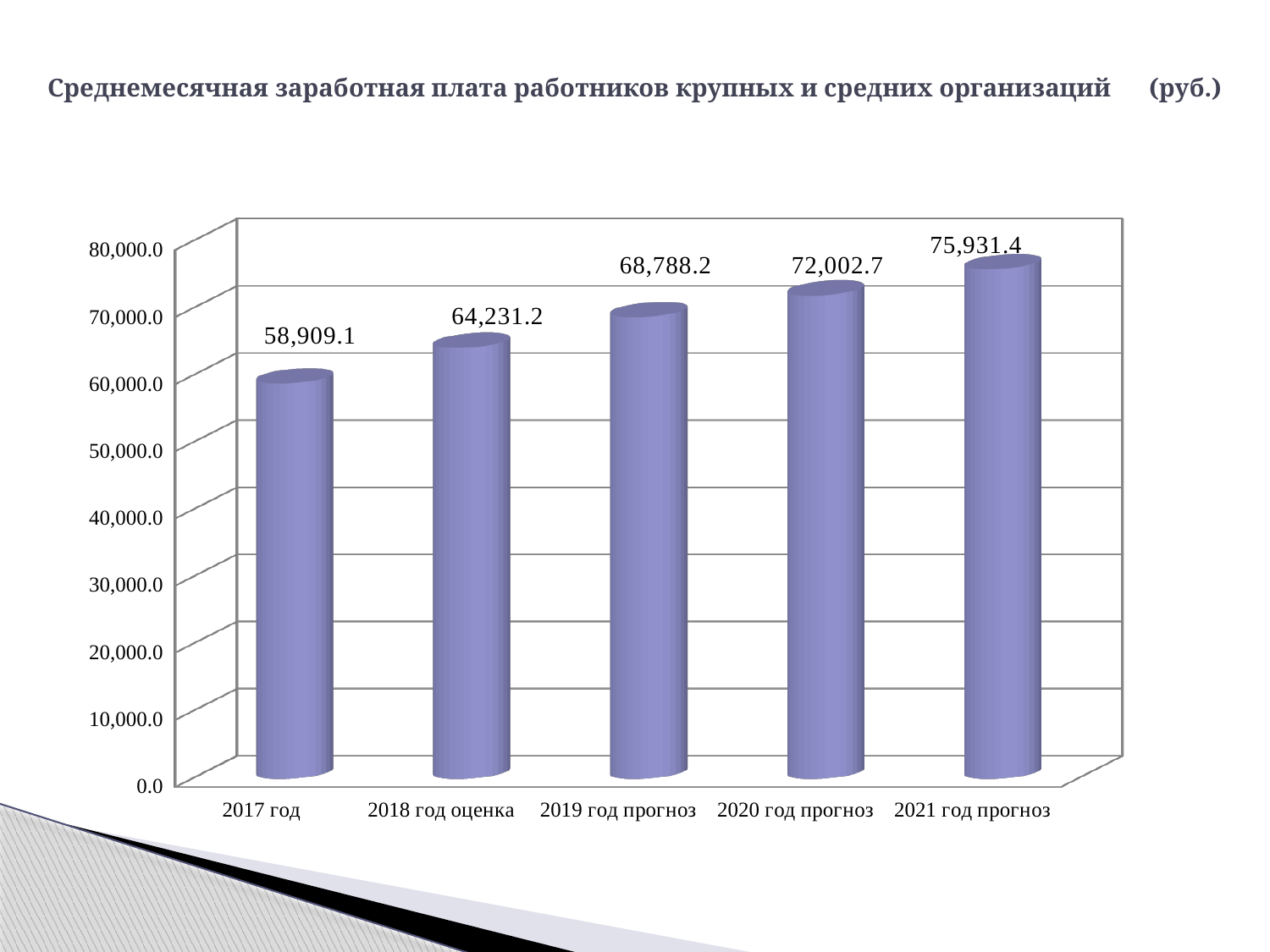
What is the value for 2017 год? 58,909.1 What kind of chart is shown on the slide? bar chart Which category has the lowest value? 2017 год What is the difference between the values for 2020 год прогноз and 2019 год прогноз? 3,214.5 Is the value for 2019 год прогноз greater or less than 70,000.0? less What is the difference between the values for 2021 год прогноз and 2017 год? 17,022.3 Do the values rise or fall from 2017 год to 2021 год прогноз? rise How many categories are shown on the x axis? 5 What is the value for 2019 год прогноз? 68,788.2 What is the value for 2021 год прогноз? 75,931.4 Which is larger, the value for 2018 год оценка or the value for 2020 год прогноз? 2020 год прогноз Which category has the highest value? 2021 год прогноз